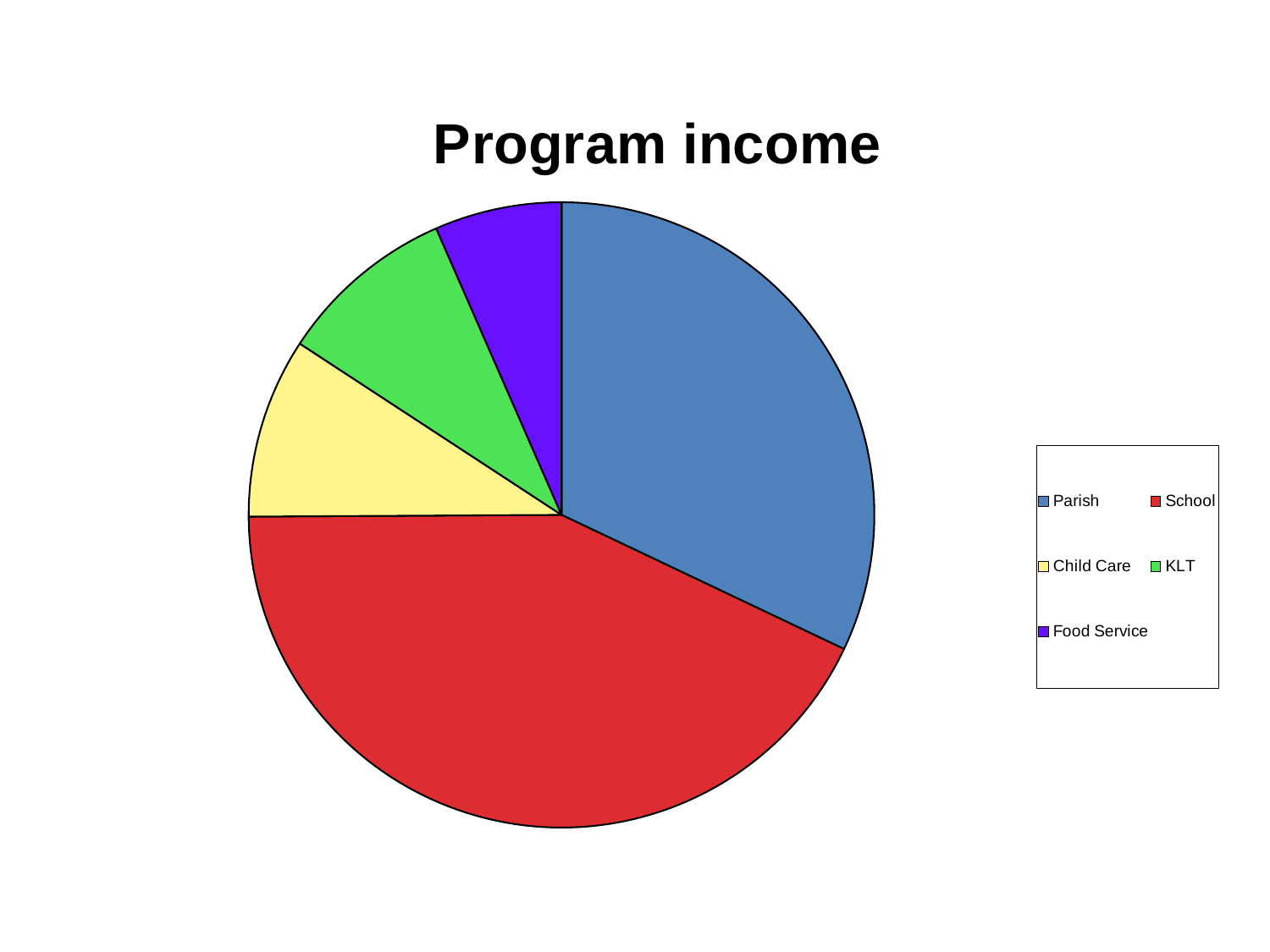
Which category has the largest slice of the pie? School Which is larger, the slice for Parish or the slice for KLT? Parish Which category has the smallest slice of the pie? Food Service Which category is shown in red on the pie chart? School Which is larger, the slice for School or the slice for Parish? School Which is larger, the slice for Parish or the slice for Food Service? Parish How many categories (slices) does the pie chart have? 5 What is the title of the chart? Program income What kind of chart is shown on the slide? pie chart